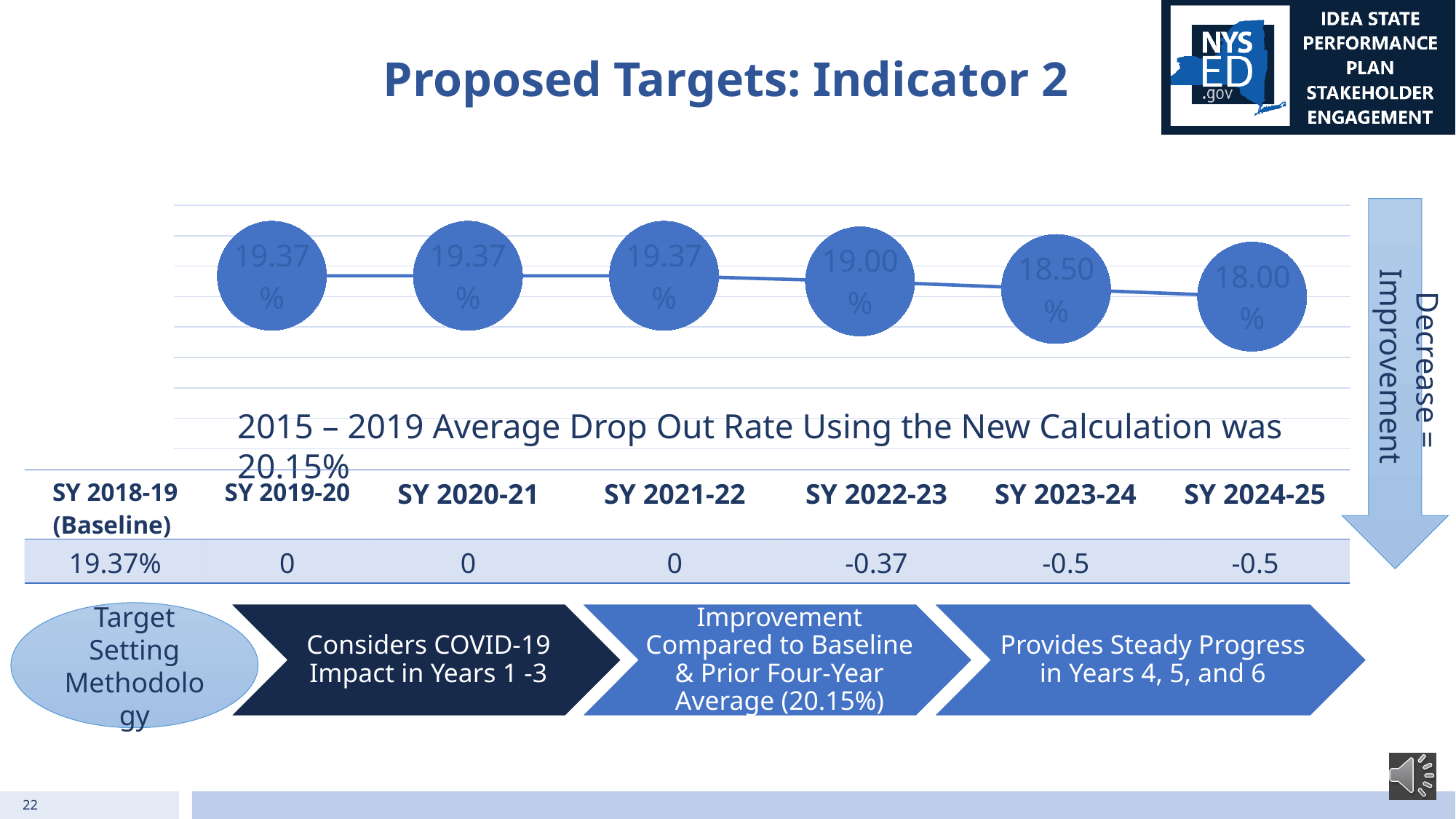
What is the value plotted for SY 2022-23? 19.00% Which is larger, the value for SY 2022-23 or the value for SY 2023-24? SY 2022-23 What is the difference between the values for SY 2022-23 and SY 2023-24? 0.50% Which school year has the lowest plotted value? SY 2024-25 What type of chart is shown on the slide? line chart Do the plotted values rise or fall from SY 2021-22 to SY 2024-25? fall According to the text on the chart, what was the 2015 – 2019 average drop out rate using the new calculation? 20.15% What is the value plotted for SY 2024-25? 18.00% What is the difference between the values for SY 2019-20 and SY 2024-25? 1.37% What is the value plotted for SY 2023-24? 18.50% How many data points are plotted on the line chart? 6 What is the value plotted for SY 2019-20? 19.37%